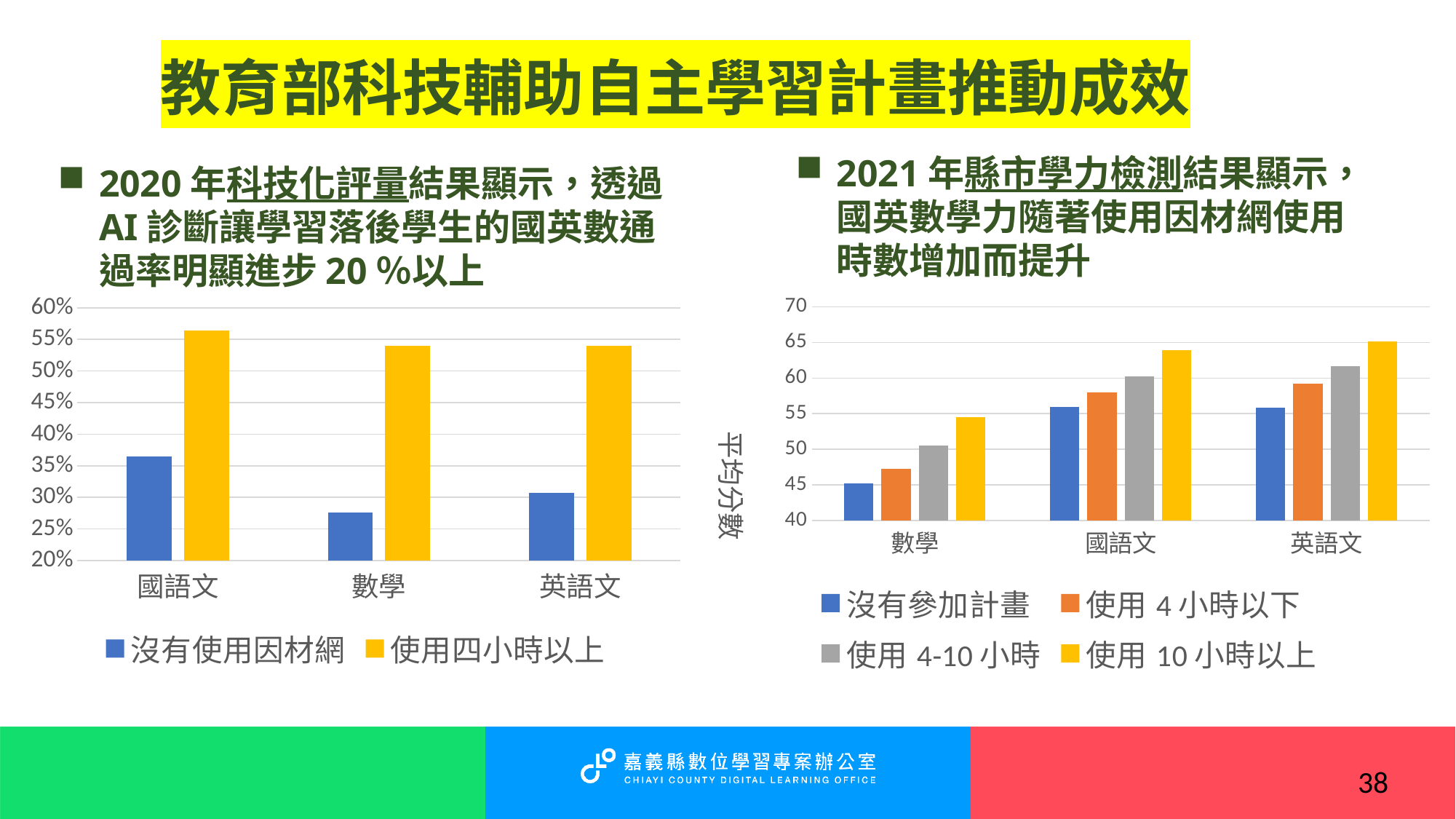
In the right chart, is the value for 使用 10 小時以上 in 英語文 greater or less than 60? greater In the right chart, which subject has the lowest value for 使用 10 小時以上? 數學 In the left chart, which subject has the highest value for 沒有使用因材網? 國語文 How many subject categories are shown on the x axis of the right chart? 3 In the left chart, is the value for 沒有使用因材網 in 數學 greater or less than 30%? less In the left chart, is the value for 使用四小時以上 in 國語文 greater or less than 55%? greater How many series does the legend of the left chart list? 2 In the left chart, which subject has the lowest value for 沒有使用因材網? 數學 In the right chart, for 國語文, which is larger: 沒有參加計畫 or 使用 4-10 小時? 使用 4-10 小時 What kind of chart is the chart on the left side of the slide? bar chart How many series does the legend of the right chart list? 4